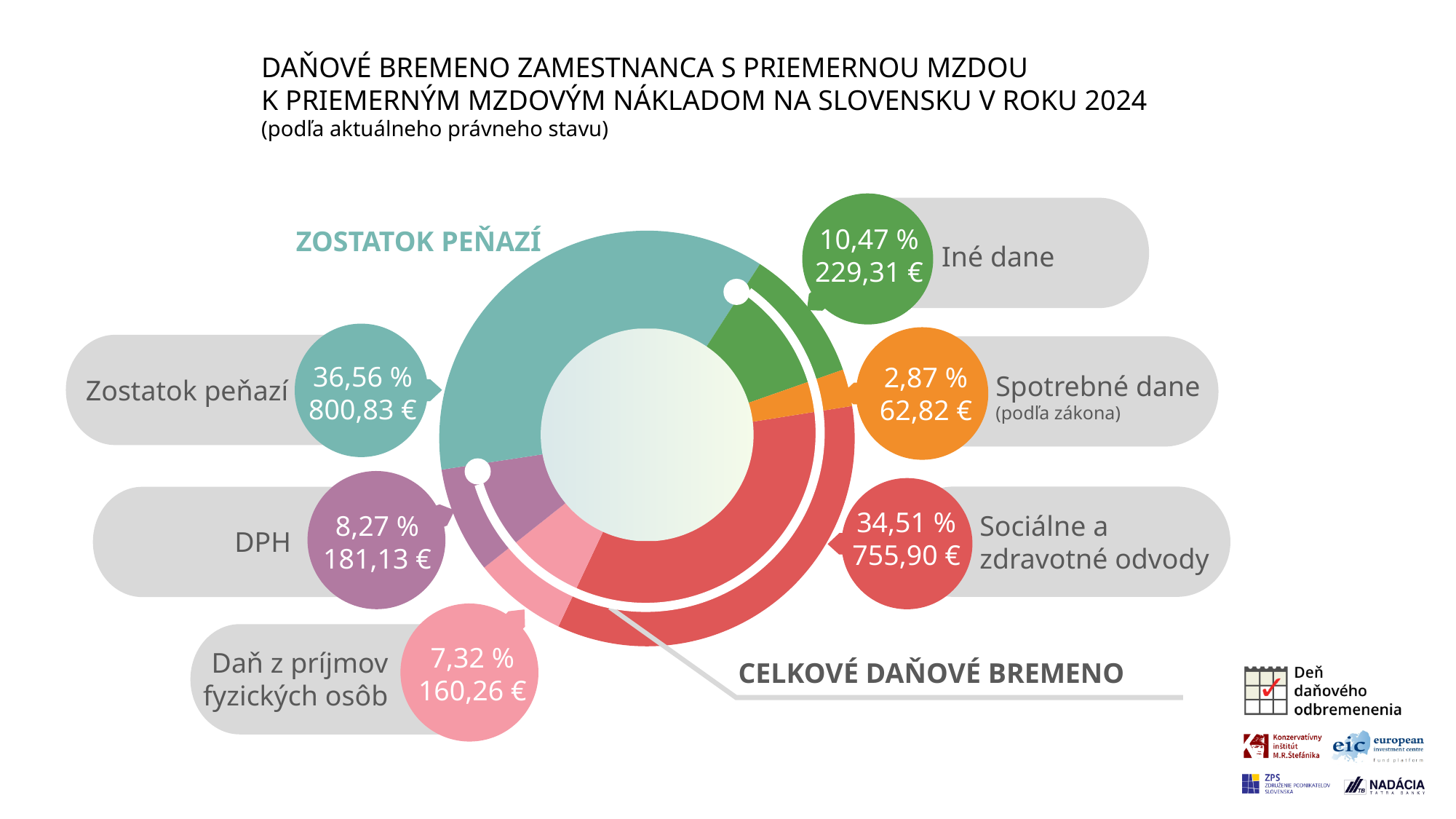
What is the difference in euros between Zostatok peňazí and Sociálne a zdravotné odvody? 44,93 € Which segment has the smallest share of the donut chart? Spotrebné dane What amount in euros is shown for DPH? 181,13 € What label is given to the part of the donut chart that excludes Zostatok peňazí? CELKOVÉ DAŇOVÉ BREMENO What percentage share is shown for Spotrebné dane? 2,87 % Which is larger in euros: Iné dane or DPH? Iné dane How many segments does the donut chart have? 6 What amount in euros is shown for Sociálne a zdravotné odvody? 755,90 € What type of chart is shown on the slide? Pie (donut) chart What percentage share is shown for Zostatok peňazí? 36,56 % What is the difference in euros between Iné dane and Daň z príjmov fyzických osôb? 69,05 € Which segment has the largest share of the donut chart? Zostatok peňazí